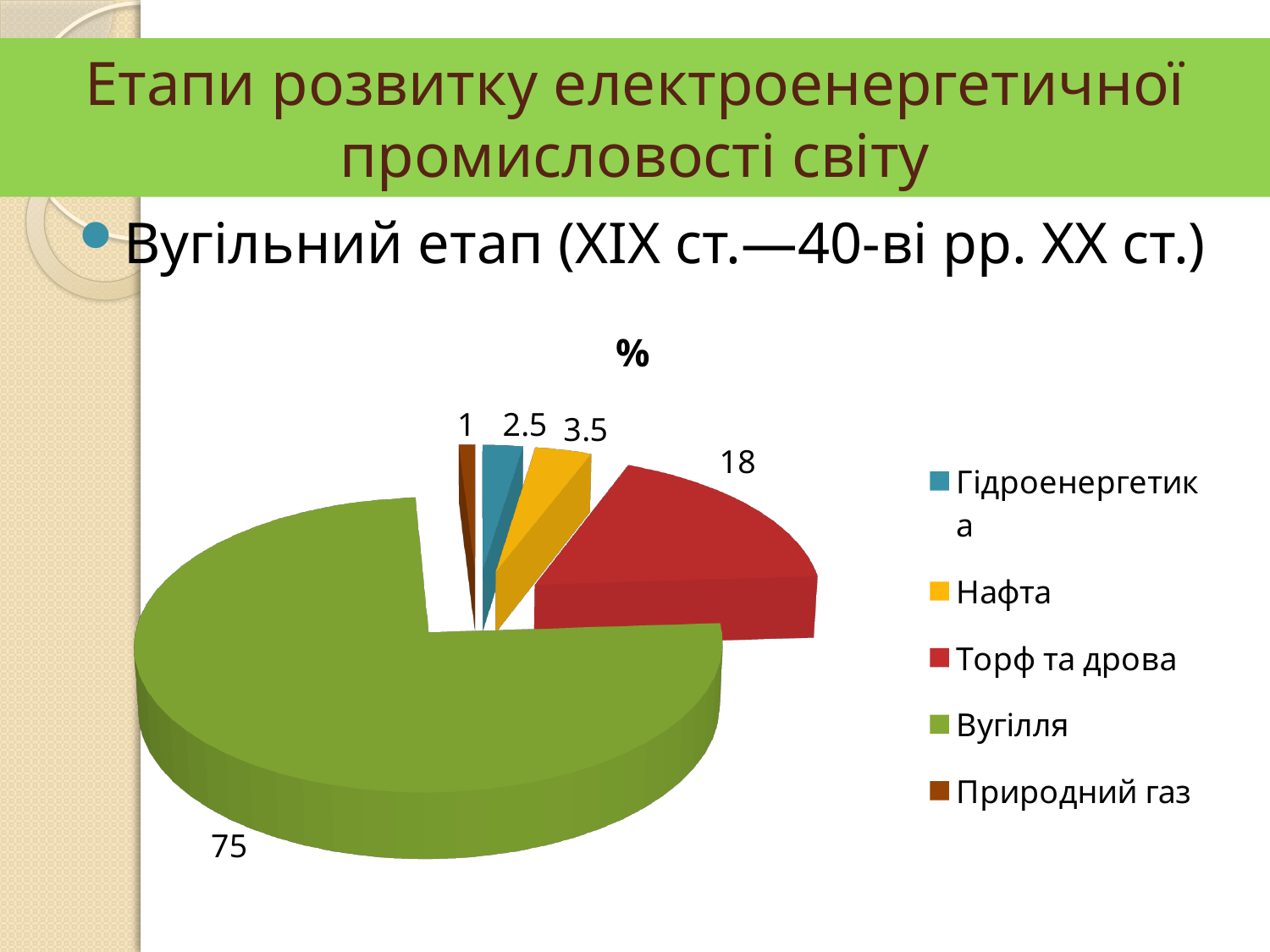
Which category has the smallest slice? Природний газ How many categories does the legend list? 5 What is the value for Торф та дрова? 18 What is the difference between the values for Вугілля and Торф та дрова? 57 What is the value for Нафта? 3.5 What is the value for Вугілля? 75 What is the title of the chart? % What is the value for Природний газ? 1 What is the value for Гідроенергетика? 2.5 Which category has the largest slice? Вугілля Which is larger, the value for Нафта or the value for Гідроенергетика? Нафта What kind of chart is shown on the slide? pie chart